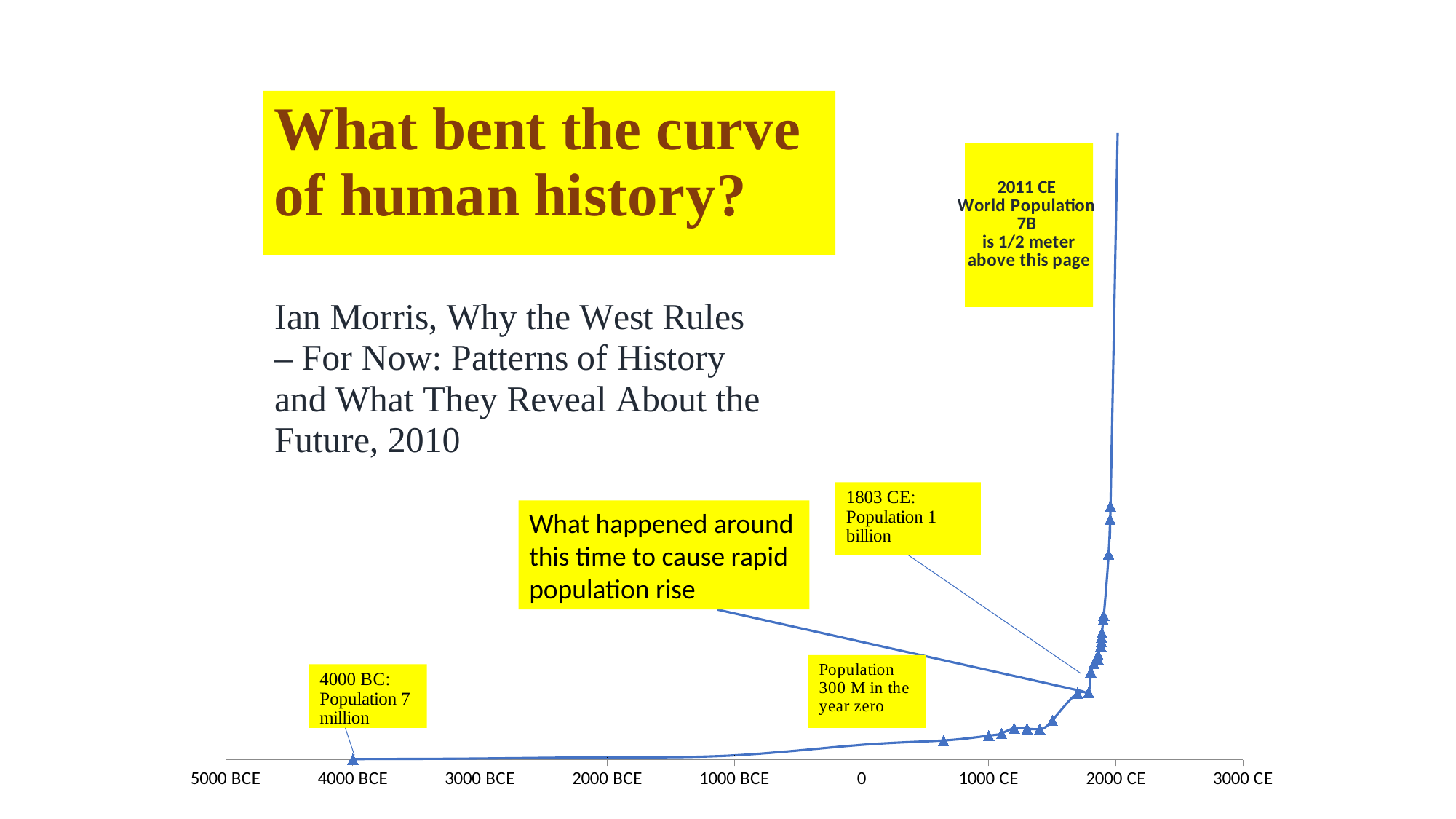
What is the last tick label on the x axis? 3000 CE Which annotated year has the highest population value on the chart? 2011 CE What kind of chart is shown on the slide? line chart According to the annotation, what was the world population in 2011 CE? 7B According to the annotation, what was the population in 4000 BC? 7 million Which is larger: the population in 1803 CE or the population in the year zero? 1803 CE Do the plotted values rise or fall as the x axis moves from 5000 BCE toward 2000 CE? rise What is the first tick label on the x axis? 5000 BCE According to the annotation, what was the population in 1803 CE? 1 billion How many tick labels are shown on the x axis? 9 Which annotated year has the lowest population value on the chart? 4000 BC According to the annotation, what was the population in the year zero? 300 M